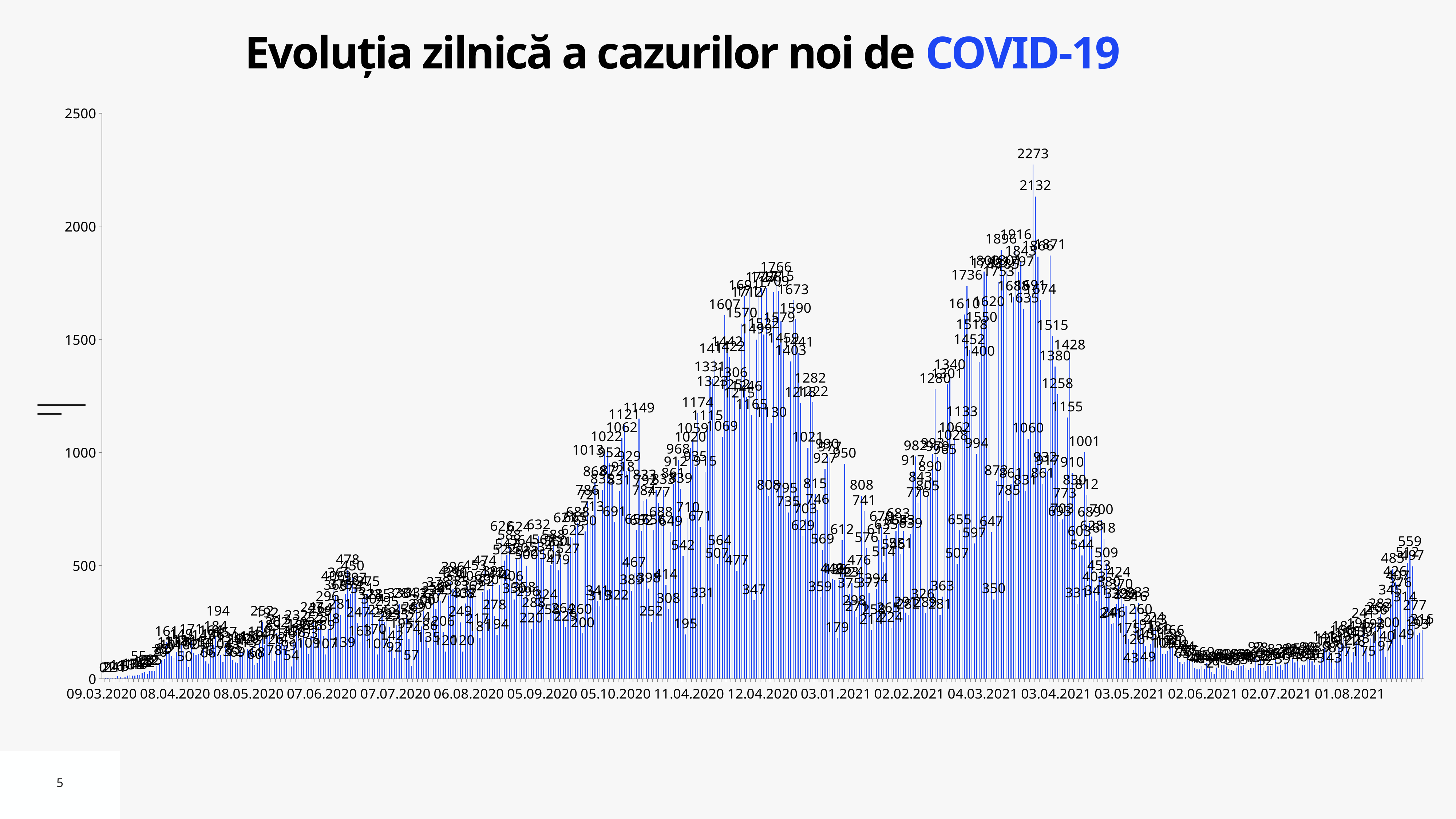
What is the first date label on the x axis? 09.03.2020 What is the title of the chart? Evoluția zilnică a cazurilor noi de COVID-19 Do the values rise or fall between the 03.05.2021 and 02.06.2021 ticks? fall What is the last date label on the x axis? 01.08.2021 Do the values rise or fall from the 02.07.2021 tick to the right end of the chart? rise What is the difference between the two highest labeled values, 2273 and 2132? 141 What kind of chart is shown on the slide? bar chart Are the values around the 02.06.2021 tick greater or less than 500? less What is the highest daily value labeled on the chart? 2273 What is the maximum value shown on the y axis? 2500 Is the tallest bar on the chart greater or less than 2000? greater What is the second-highest value labeled on the chart, next to the 2273 peak? 2132